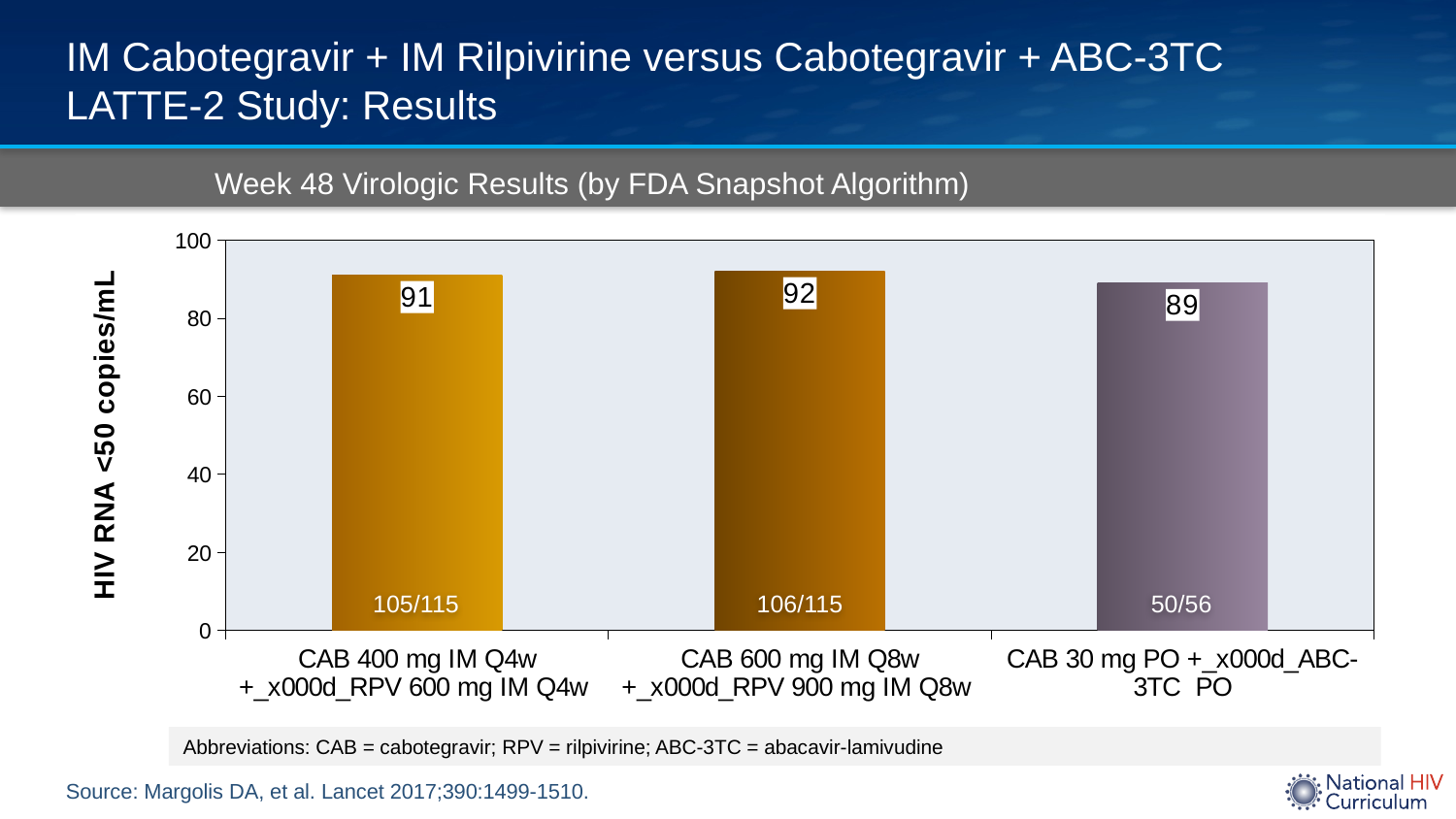
Which is larger: the value for CAB 400 mg IM Q4w + RPV 600 mg IM Q4w or the value for CAB 30 mg PO + ABC-3TC PO? CAB 400 mg IM Q4w + RPV 600 mg IM Q4w What kind of chart is shown? bar chart What is the value for CAB 400 mg IM Q4w + RPV 600 mg IM Q4w? 91 Is the value for CAB 30 mg PO + ABC-3TC PO greater or less than 80? greater What fraction is printed inside the bar for CAB 600 mg IM Q8w + RPV 900 mg IM Q8w? 106/115 What is the value for CAB 600 mg IM Q8w + RPV 900 mg IM Q8w? 92 How many categories are shown on the x axis? 3 Which category has the lowest value? CAB 30 mg PO + ABC-3TC PO What is the y-axis label of the chart? HIV RNA <50 copies/mL What is the value for CAB 30 mg PO + ABC-3TC PO? 89 Which category has the highest value? CAB 600 mg IM Q8w + RPV 900 mg IM Q8w What is the difference between the values for CAB 600 mg IM Q8w + RPV 900 mg IM Q8w and CAB 30 mg PO + ABC-3TC PO? 3